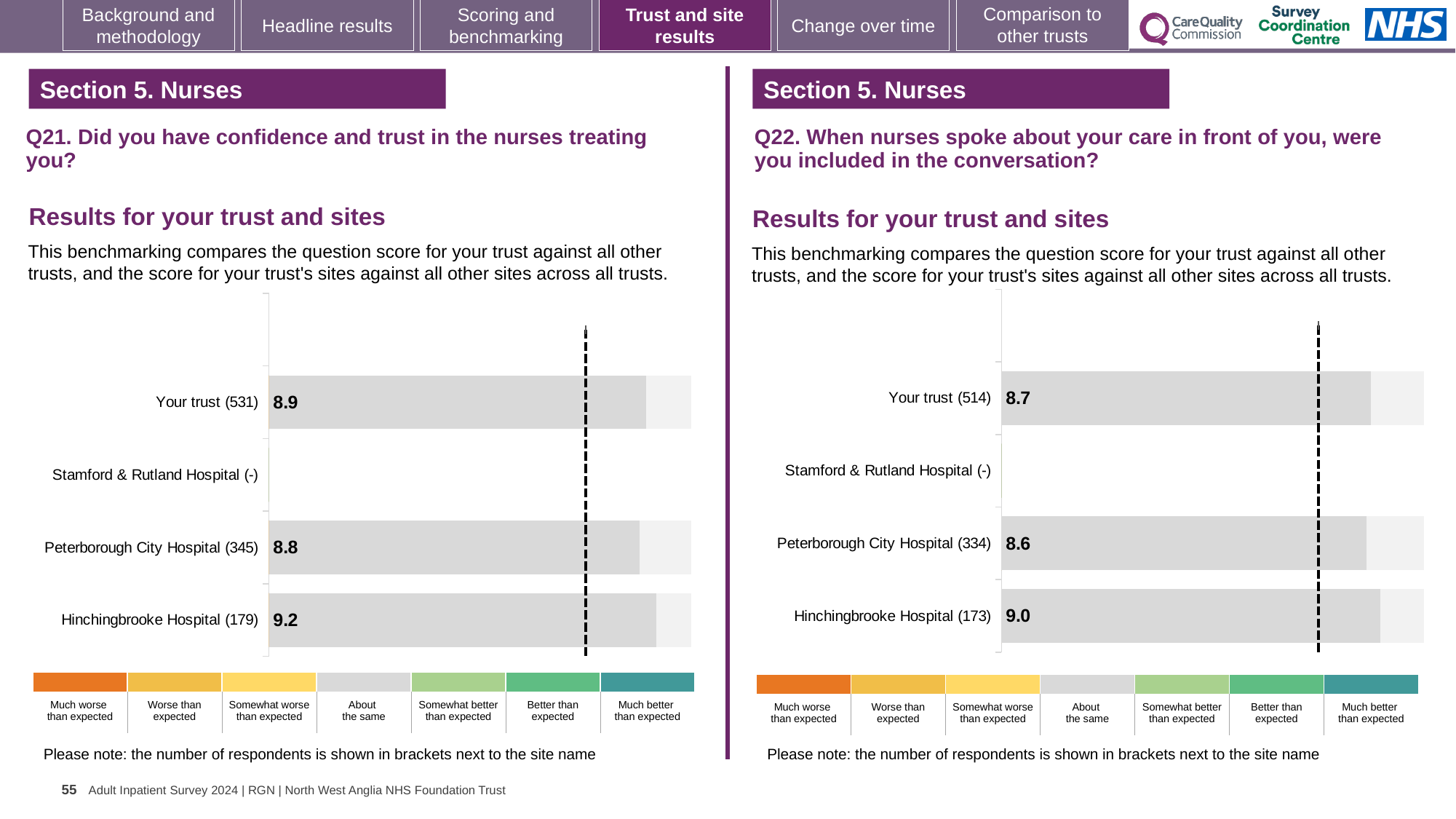
In the Q22 chart on the right, what is the difference between the scores for Hinchingbrooke Hospital and Your trust? 0.3 In the Q22 chart on the right, which of the scored rows has the lowest score? Peterborough City Hospital In the Q22 chart on the right, is the score for Hinchingbrooke Hospital larger or smaller than the score for Your trust? larger What kind of chart is used on the left for Q21? bar chart In the Q21 chart on the left, what is the score for Hinchingbrooke Hospital? 9.2 In the Q21 chart on the left, what is the score for Your trust? 8.9 In the Q22 chart on the right, how many rows (trust and sites) are listed on the vertical axis? 4 In the Q22 chart on the right, what is the score for Your trust? 8.7 In the Q22 chart on the right, what is the score for Peterborough City Hospital? 8.6 In the Q21 chart on the left, how many respondents are shown in brackets for Peterborough City Hospital? 345 In the Q21 chart on the left, what is the difference between the scores for Hinchingbrooke Hospital and Peterborough City Hospital? 0.4 In the Q21 chart on the left, which site or trust has the highest score? Hinchingbrooke Hospital